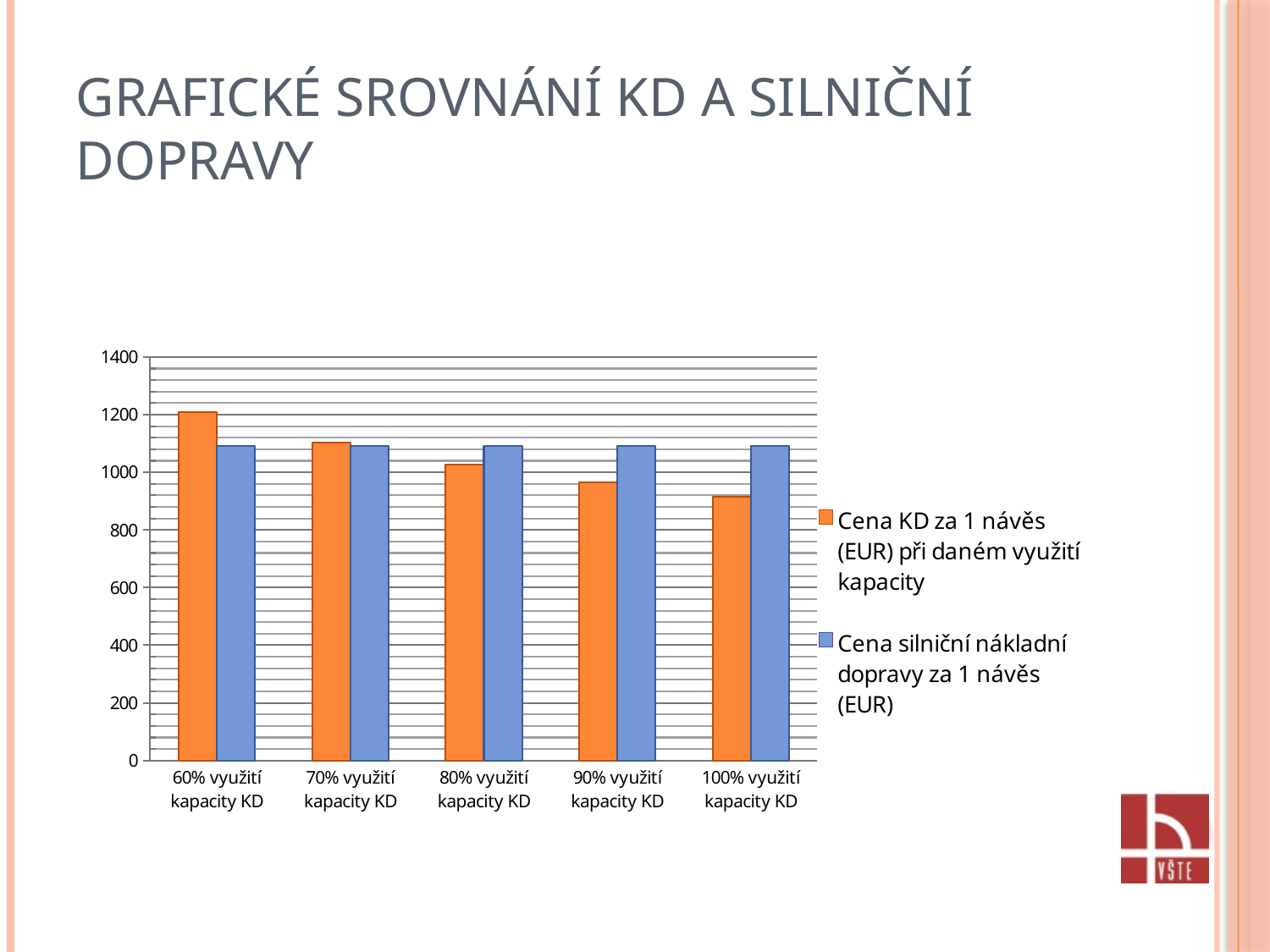
Is the value of 'Cena silniční nákladní dopravy za 1 návěs (EUR)' at 80% využití kapacity KD greater or less than 1200? less How many categories are shown on the x axis of the chart? 5 At 100% využití kapacity KD, which series has the larger value: 'Cena KD za 1 návěs (EUR) při daném využití kapacity' or 'Cena silniční nákladní dopravy za 1 návěs (EUR)'? Cena silniční nákladní dopravy za 1 návěs (EUR) Do the values of the series 'Cena KD za 1 návěs (EUR) při daném využití kapacity' rise or fall from left to right along the x axis? fall How many series does the chart's legend list? 2 What colour are the bars for the series 'Cena silniční nákladní dopravy za 1 návěs (EUR)'? blue Is the value of 'Cena KD za 1 návěs (EUR) při daném využití kapacity' at 60% využití kapacity KD greater or less than 1000? greater Is the value of 'Cena KD za 1 návěs (EUR) při daném využití kapacity' at 100% využití kapacity KD greater or less than 1000? less Which category has the lowest value for the series 'Cena KD za 1 návěs (EUR) při daném využití kapacity'? 100% využití kapacity KD What kind of chart is shown on the slide? bar chart Which category has the highest value for the series 'Cena KD za 1 návěs (EUR) při daném využití kapacity'? 60% využití kapacity KD At 60% využití kapacity KD, which series has the larger value: 'Cena KD za 1 návěs (EUR) při daném využití kapacity' or 'Cena silniční nákladní dopravy za 1 návěs (EUR)'? Cena KD za 1 návěs (EUR) při daném využití kapacity